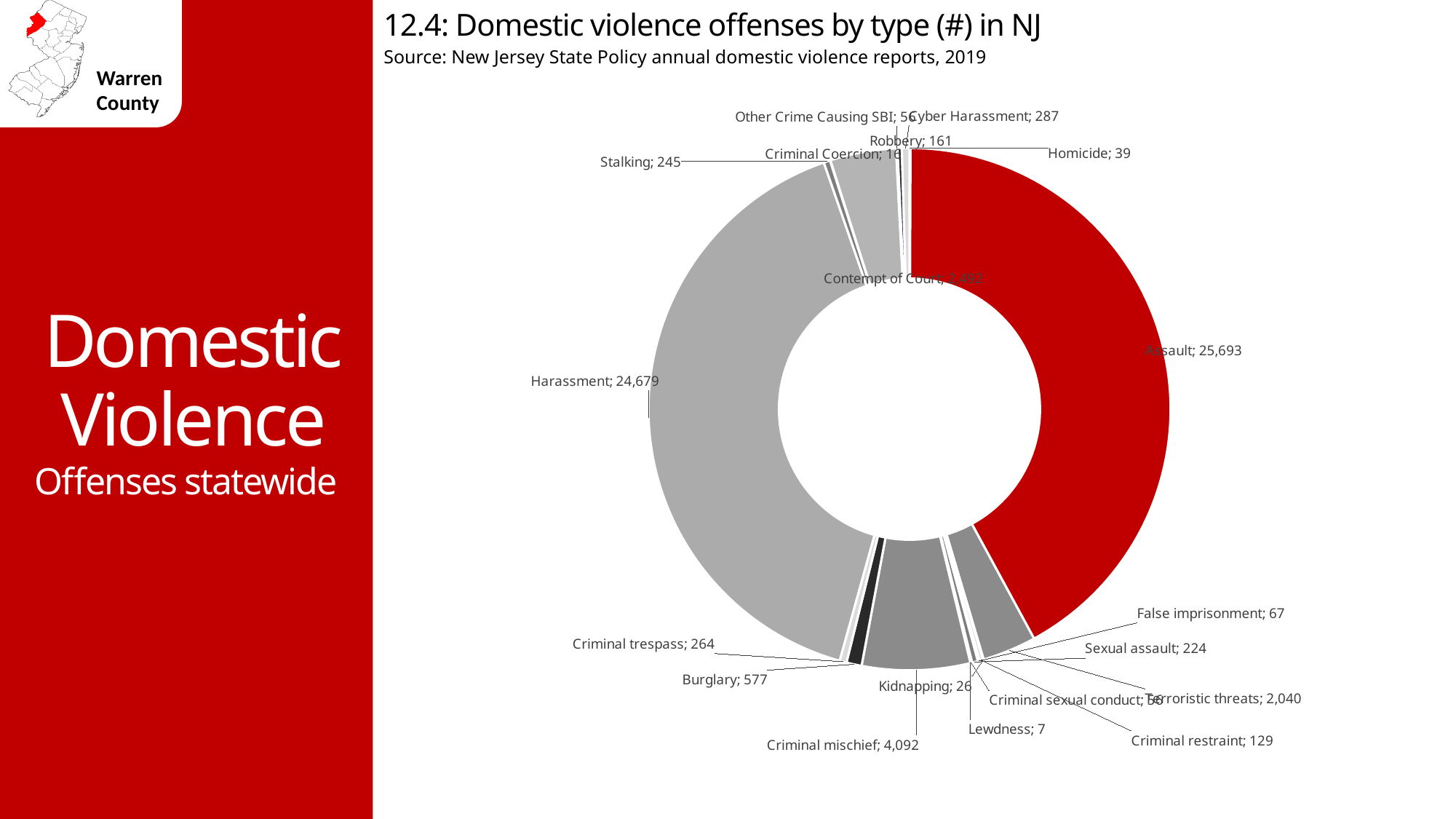
What is the number of Assault offenses shown on the chart? 25,693 What value is shown for Terroristic threats? 2,040 What colour is the Assault slice of the chart? Red Which offense type has the highest number on the chart? Assault What value is shown for Burglary? 577 What value is shown for Lewdness? 7 How many more Assault offenses are there than Harassment offenses? 1,014 Which offense type has the lowest number on the chart? Lewdness How many Criminal mischief offenses does the chart show? 4,092 What is the number of Harassment offenses shown on the chart? 24,679 What kind of chart is used on this slide? Doughnut (pie) chart Which is larger, the value for Criminal mischief or the value for Terroristic threats? Criminal mischief